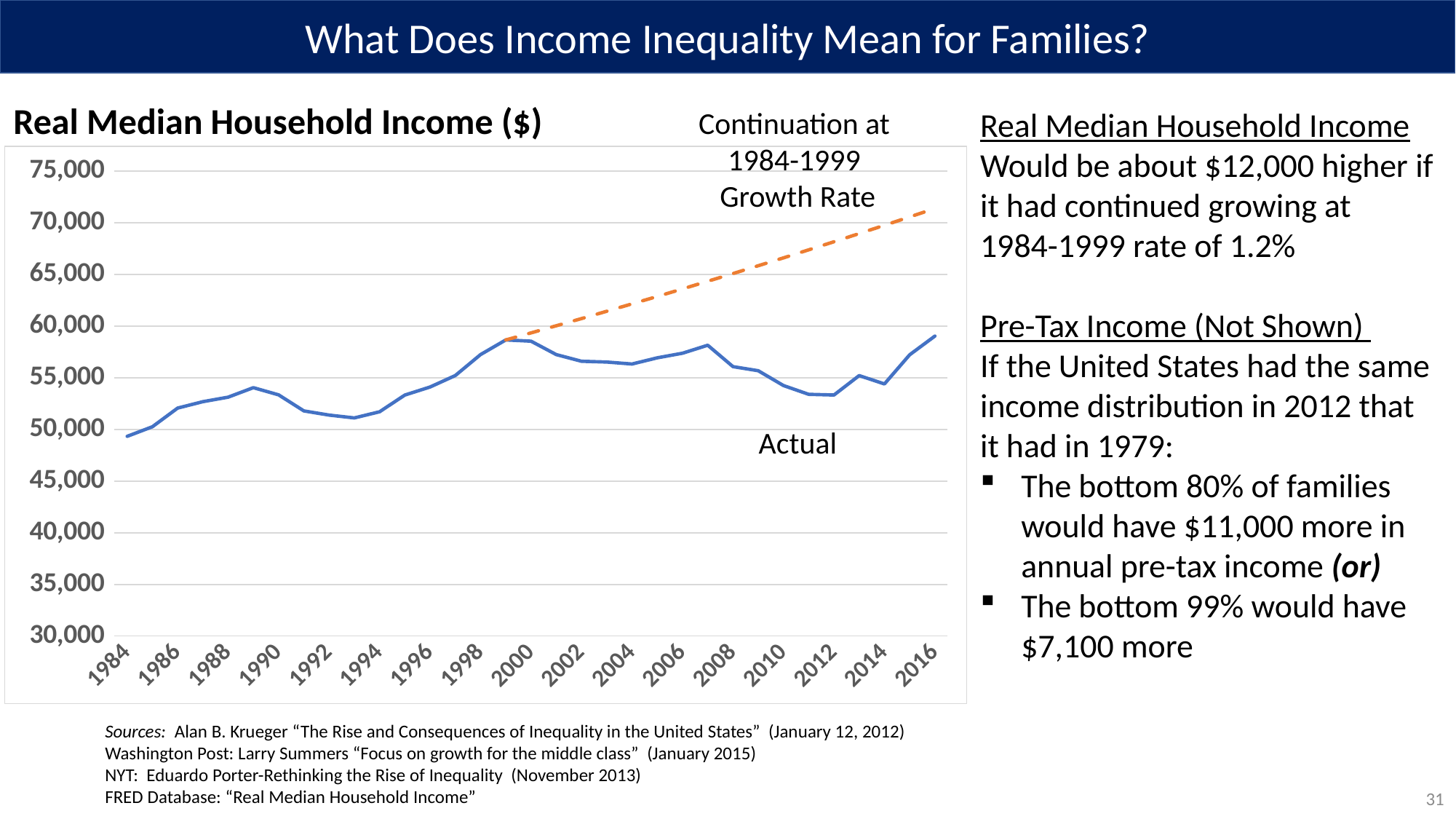
What does the orange dashed line on the chart represent? Continuation at 1984-1999 Growth Rate What is the title of the chart? Real Median Household Income ($) Is the Actual value for 2012 greater or less than 55,000? less Is the value of the Continuation at 1984-1999 Growth Rate line in 2016 greater or less than 65,000? greater Is the Actual value for 2016 greater or less than 55,000? greater How many year labels are shown on the x axis of the chart? 17 In which year is the Actual line at its lowest value? 1984 Does the Actual line rise or fall between 1984 and 1999? rise In 2016, which is larger: the Actual line or the Continuation at 1984-1999 Growth Rate line? Continuation at 1984-1999 Growth Rate What kind of chart is shown on the slide? line chart Does the Actual line rise or fall between 2007 and 2012? fall